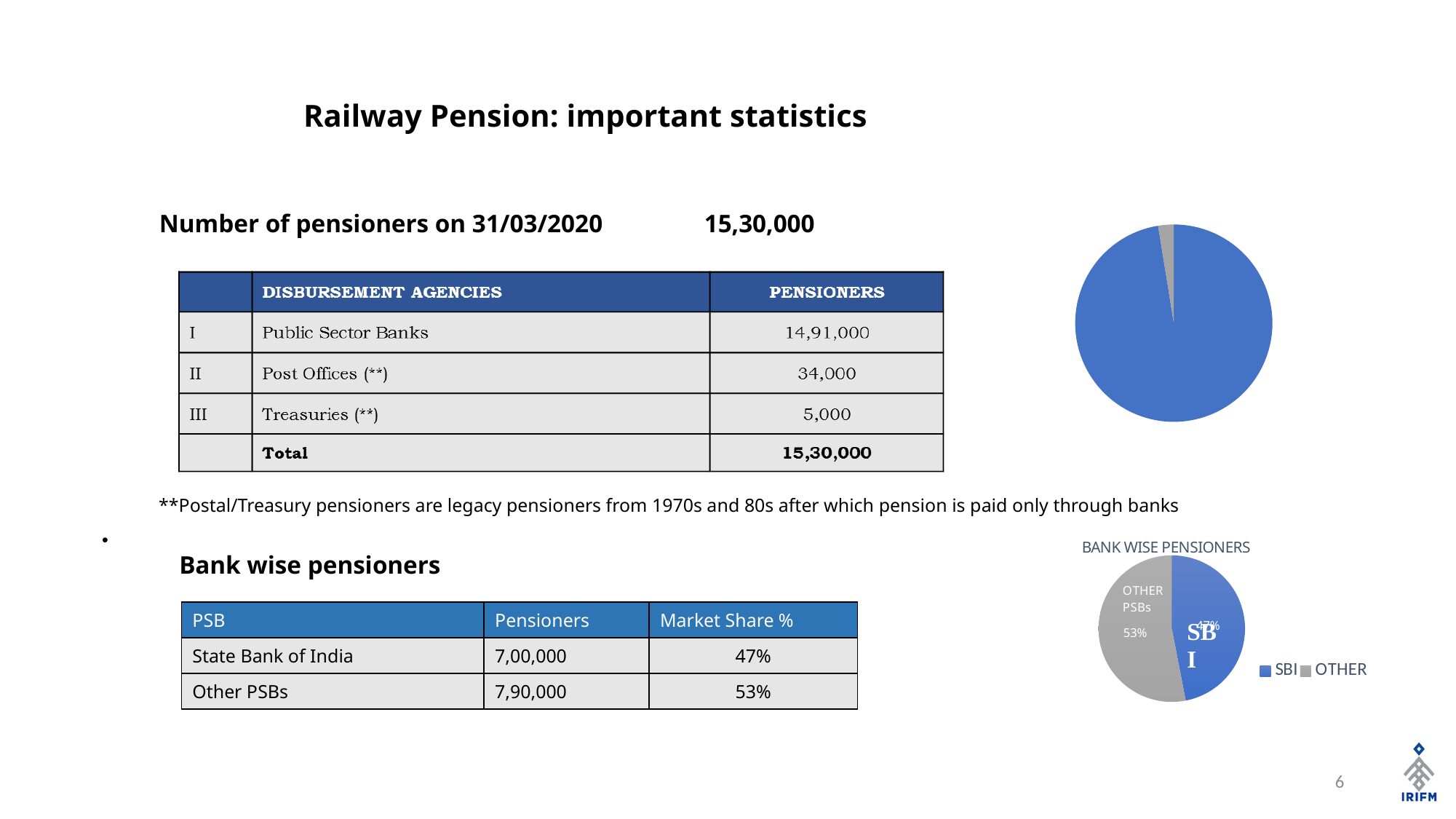
What colour is the SBI slice in the 'BANK WISE PENSIONERS' pie chart? Blue In the 'BANK WISE PENSIONERS' pie chart, what is the difference in percentage points between the OTHER PSBs share and the SBI share? 6 percentage points How many slices does the 'BANK WISE PENSIONERS' pie chart have? 2 How many slices does the pie chart at the top right of the slide have? 2 What kind of chart is shown at the top right of the slide, next to the disbursement agencies table? Pie chart In the 'BANK WISE PENSIONERS' pie chart, what share of the pie does OTHER PSBs have? 53% How many entries does the legend of the 'BANK WISE PENSIONERS' pie chart list? 2 In the 'BANK WISE PENSIONERS' pie chart, which category has the largest slice? OTHER PSBs In the 'BANK WISE PENSIONERS' pie chart, which category has the smallest slice? SBI In the 'BANK WISE PENSIONERS' pie chart, what share of the pie does SBI have? 47% In the 'BANK WISE PENSIONERS' pie chart, which slice is larger, SBI or OTHER PSBs? OTHER PSBs What kind of chart is the 'BANK WISE PENSIONERS' chart at the bottom right of the slide? Pie chart